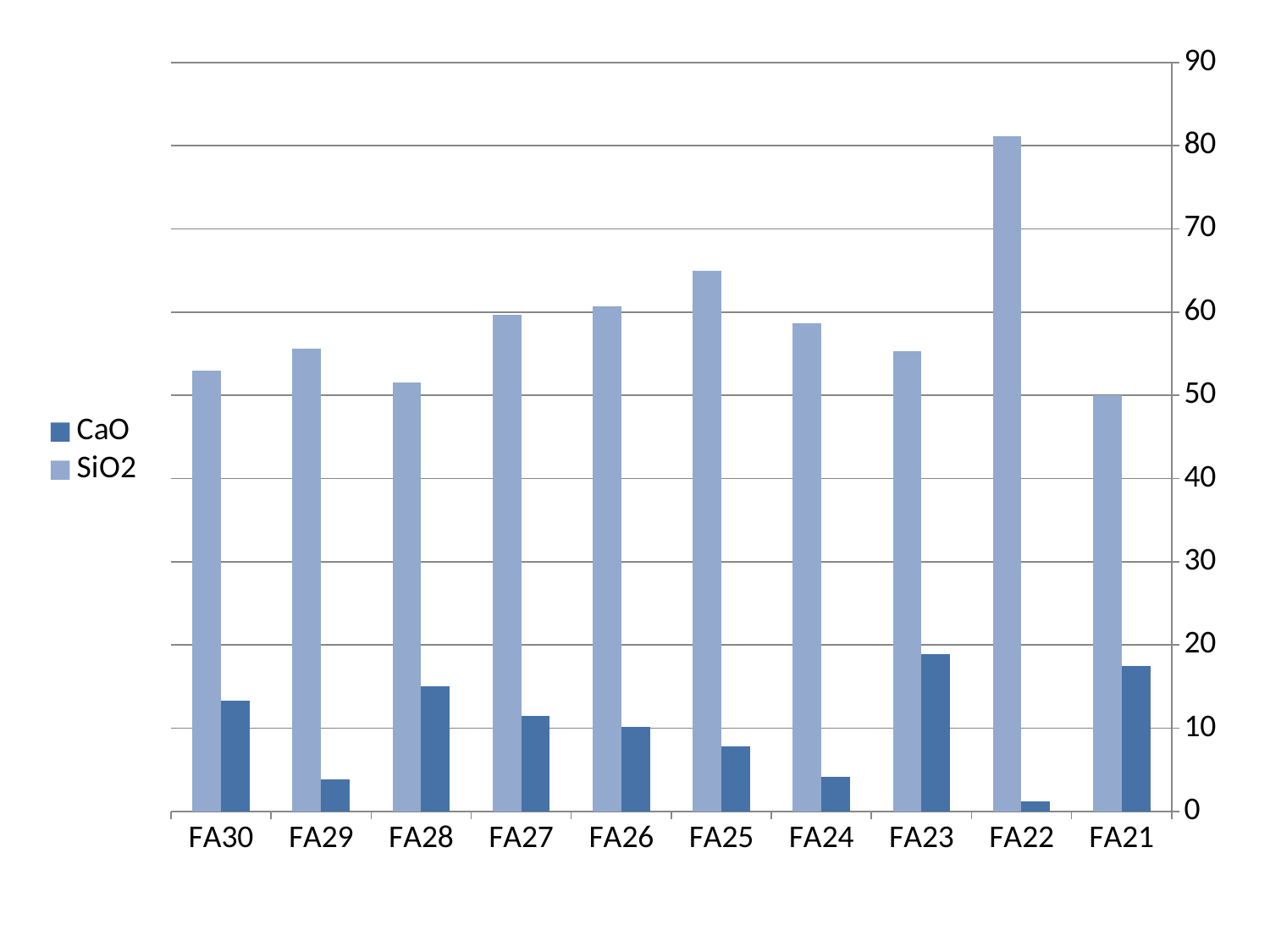
Which category has the highest SiO2 value? FA22 Which category has the lowest CaO value? FA22 Is the SiO2 value for FA22 greater or less than 70? greater Is the SiO2 value for FA25 greater or less than 60? greater Is the CaO value for FA29 greater or less than 10? less Which is larger, the CaO value for FA28 or the CaO value for FA29? FA28 Which series are listed in the legend? CaO and SiO2 Which is larger, the SiO2 value for FA22 or the SiO2 value for FA21? FA22 What kind of chart is shown on the slide? bar chart Which category has the highest CaO value? FA23 How many series does the legend list? 2 How many categories are shown on the x axis? 10